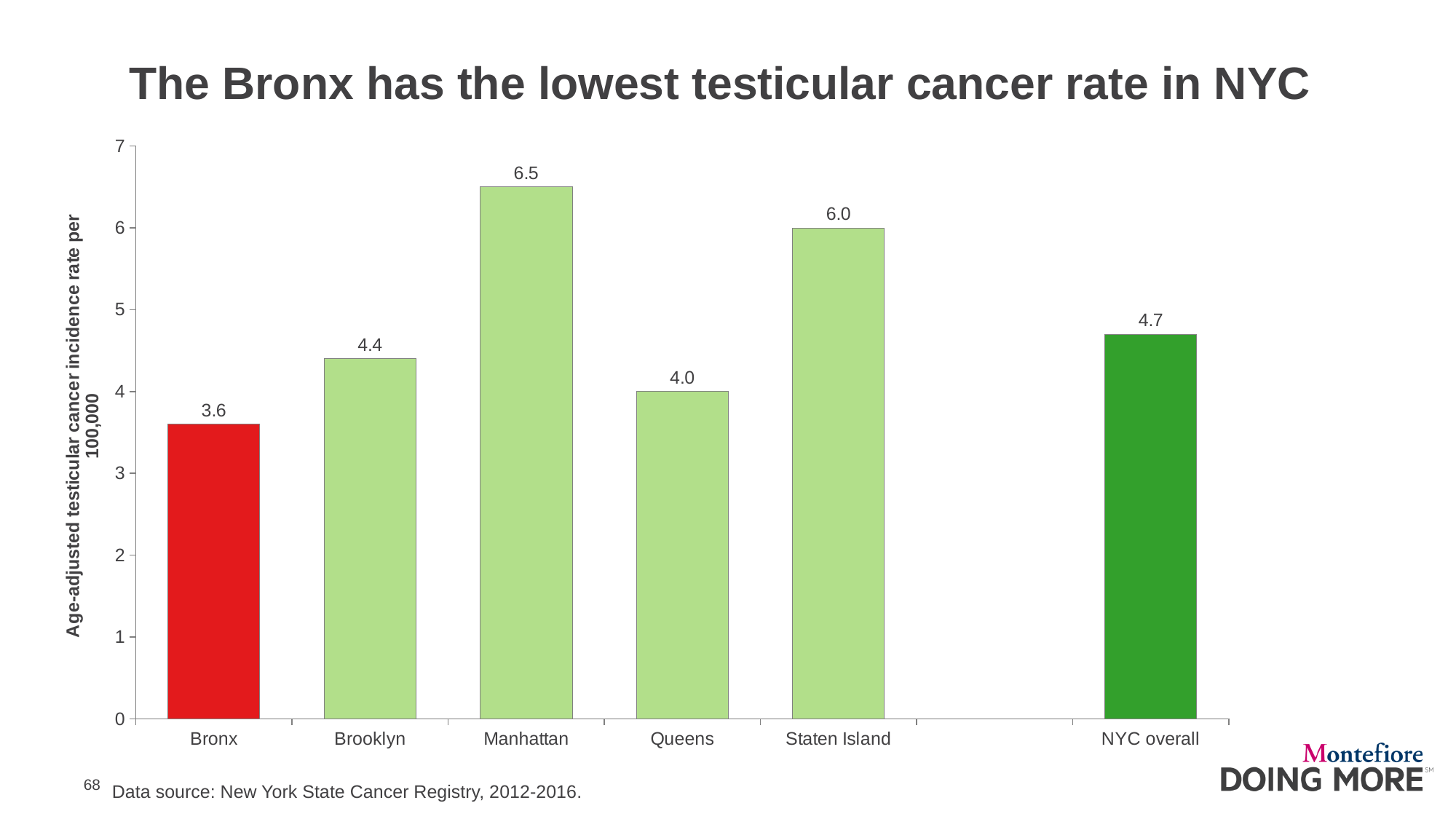
Is the value for Staten Island greater or less than 5? greater What colour is the bar for the Bronx? Red What is the age-adjusted testicular cancer incidence rate per 100,000 for the Bronx? 3.6 Which borough has the highest testicular cancer incidence rate? Manhattan What is the testicular cancer incidence rate shown for Manhattan? 6.5 What is the value shown for NYC overall? 4.7 How many bars are plotted on the chart? 6 Which category has the lowest value on the chart? Bronx What is the difference between the rates for Manhattan and the Bronx? 2.9 What is the difference between the Staten Island rate and the Queens rate? 2.0 Which has a higher testicular cancer incidence rate, Brooklyn or Queens? Brooklyn What kind of chart is shown on the slide? Bar chart